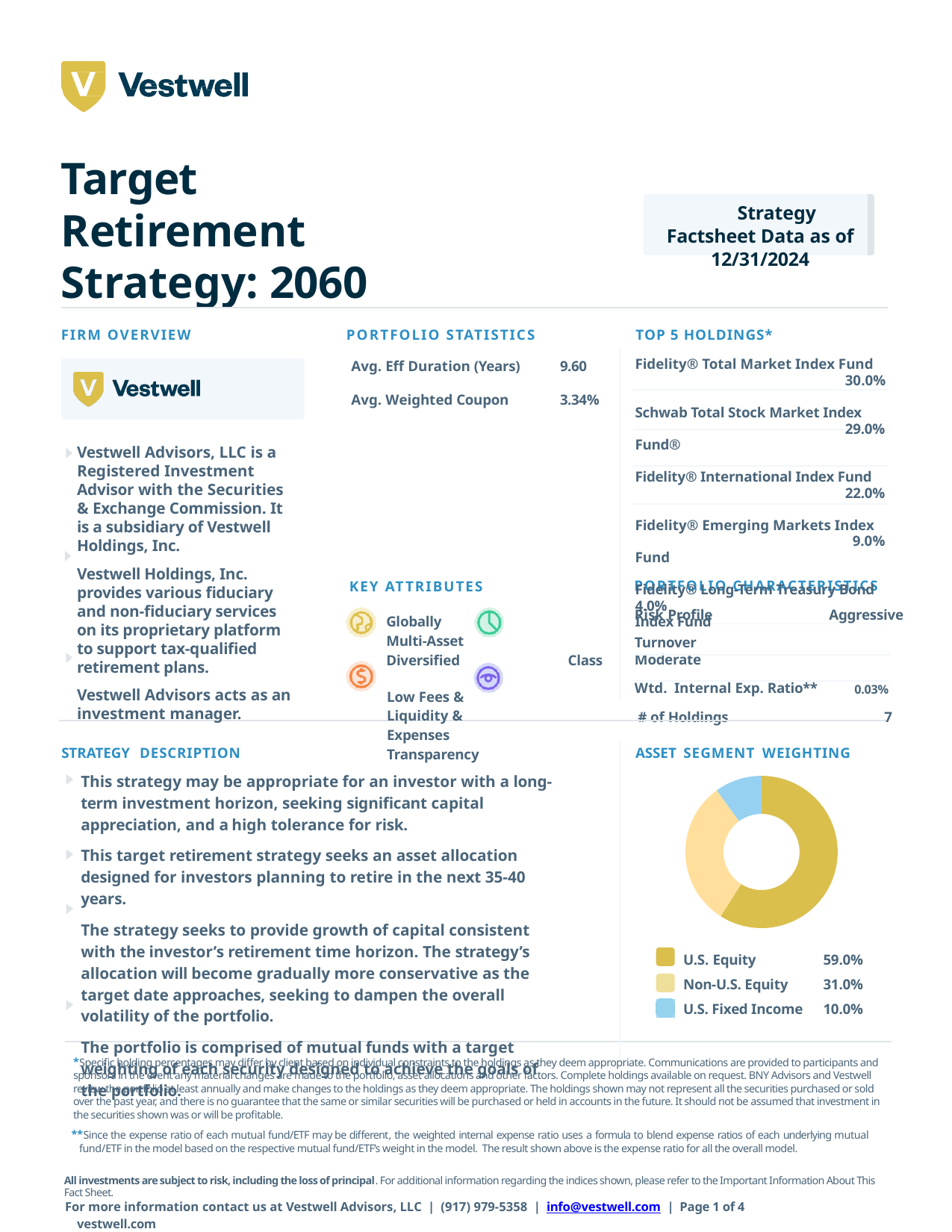
In the Asset Segment Weighting chart, which asset segment is shown in light blue? U.S. Fixed Income In the Asset Segment Weighting chart, how many asset segments are shown? 3 In the Asset Segment Weighting chart, what is the difference between the U.S. Equity and Non-U.S. Equity weightings? 28.0% In the Asset Segment Weighting chart, what is the weighting for U.S. Fixed Income? 10.0% In the Asset Segment Weighting chart, which is larger: Non-U.S. Equity or U.S. Fixed Income? Non-U.S. Equity In the Asset Segment Weighting chart, what is the weighting for U.S. Equity? 59.0% In the Asset Segment Weighting chart, what is the combined weighting of U.S. Equity and Non-U.S. Equity? 90.0% In the Asset Segment Weighting chart, which asset segment has the largest weighting? U.S. Equity In the Asset Segment Weighting chart, what is the weighting for Non-U.S. Equity? 31.0% In the Asset Segment Weighting chart, what is the difference between the Non-U.S. Equity and U.S. Fixed Income weightings? 21.0% In the Asset Segment Weighting chart, which asset segment has the smallest weighting? U.S. Fixed Income What kind of chart is shown under Asset Segment Weighting? Pie chart (donut)